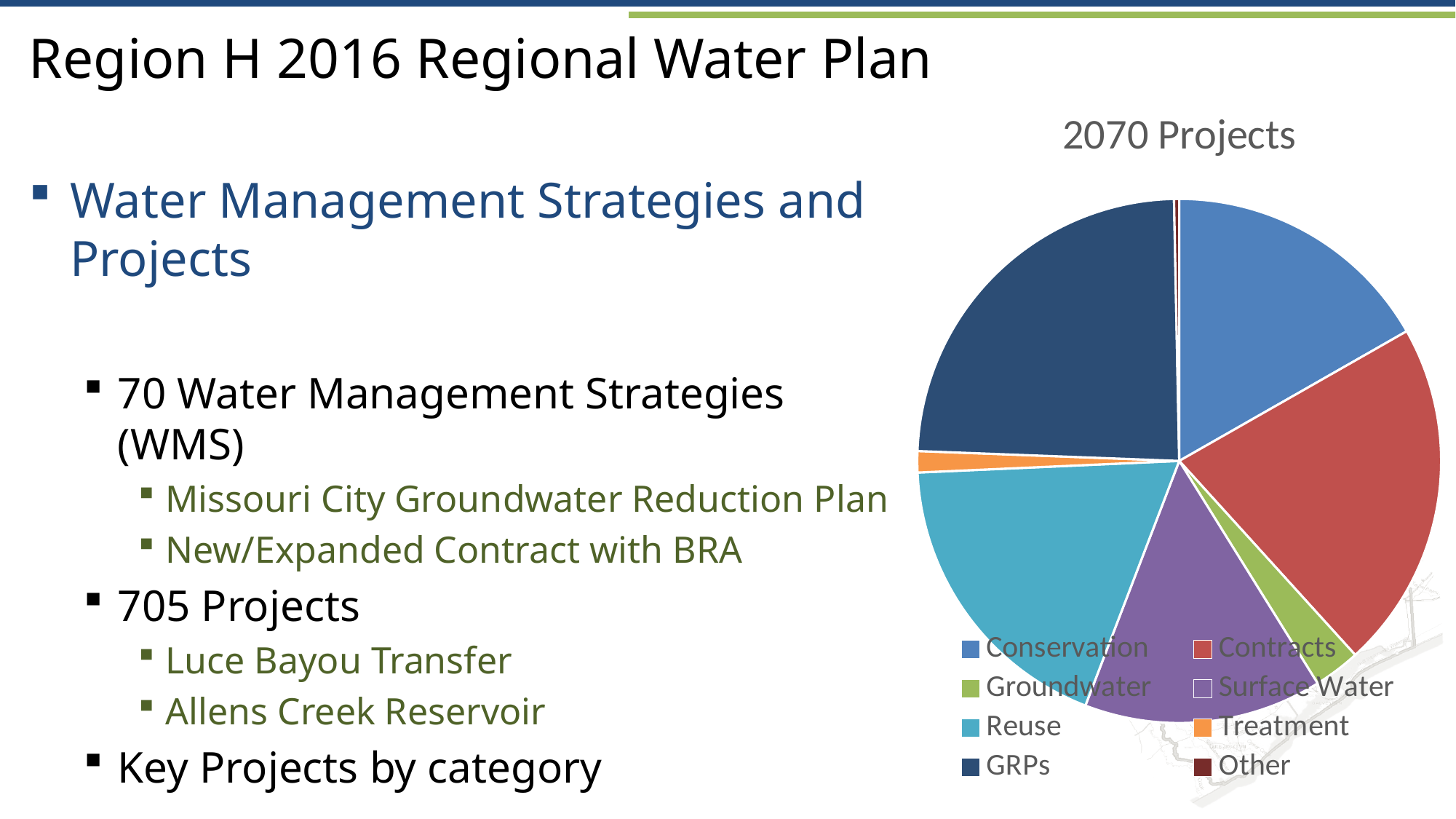
How many categories does the legend of the pie chart list? 8 What colour is the Contracts slice in the 2070 Projects pie chart? red In the 2070 Projects pie chart, which slice is larger, Conservation or Other? Conservation What is the title of the pie chart? 2070 Projects In the 2070 Projects pie chart, which slice is larger, Contracts or Groundwater? Contracts In the 2070 Projects pie chart, which slice is larger, Reuse or Treatment? Reuse What kind of chart is shown on the slide? pie chart Which category has the largest slice in the 2070 Projects pie chart? GRPs Which category has the smallest slice in the 2070 Projects pie chart? Other